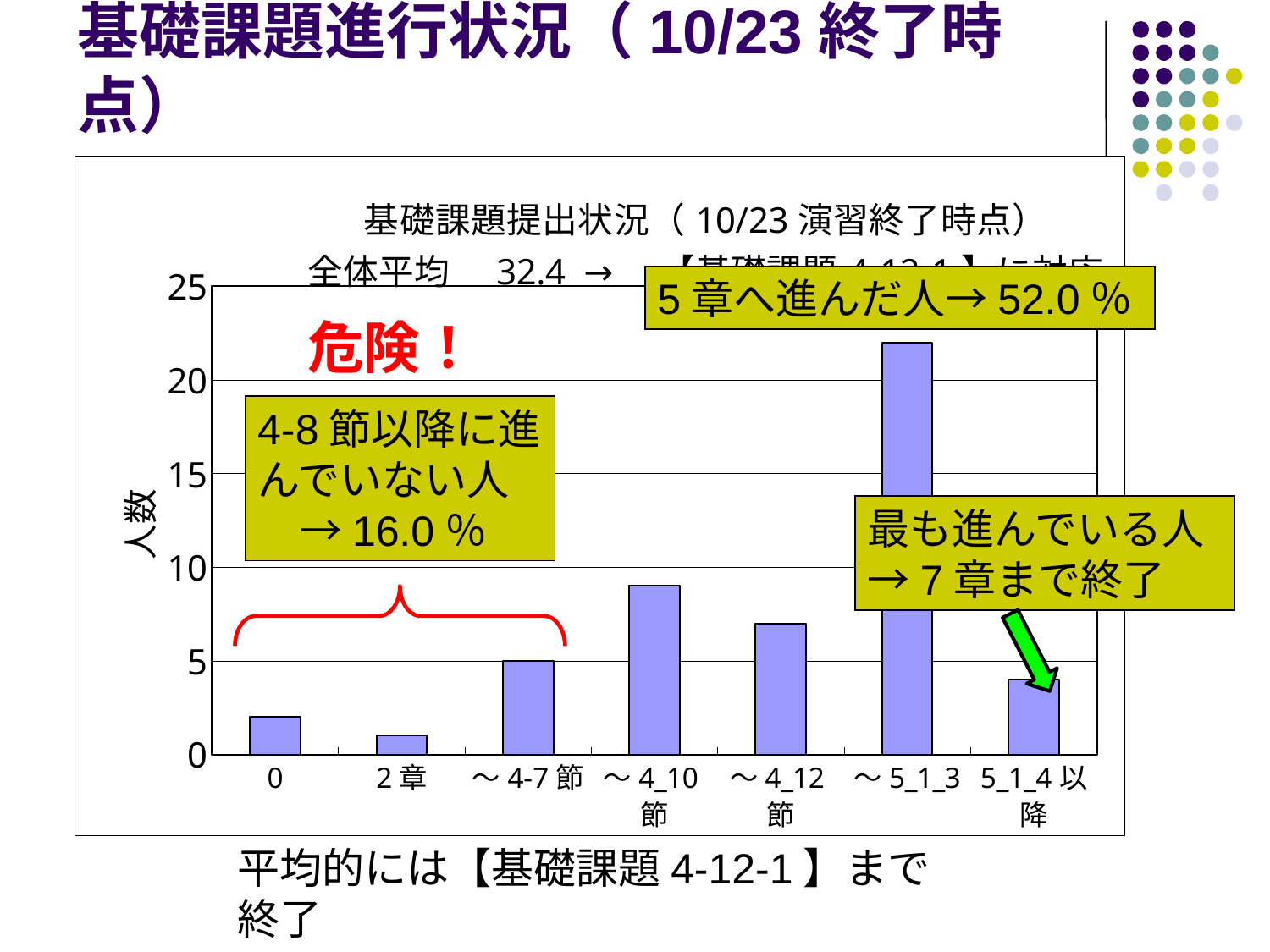
Is the value for ～4_12節 greater or less than 5? greater Is the value for ～5_1_3 greater or less than 20? greater Is the value for ～4_10節 greater or less than 10? less What is the title of the chart? 基礎課題提出状況（10/23 演習終了時点） How many categories are shown on the x axis of the chart? 7 Which is larger, the value for ～4_10節 or the value for ～4_12節? ～4_10節 Which category has the highest bar in the chart? ～5_1_3 What kind of chart is shown on the slide? bar chart Which category has the lowest bar in the chart? 2章 What is the label on the y axis of the chart? 人数